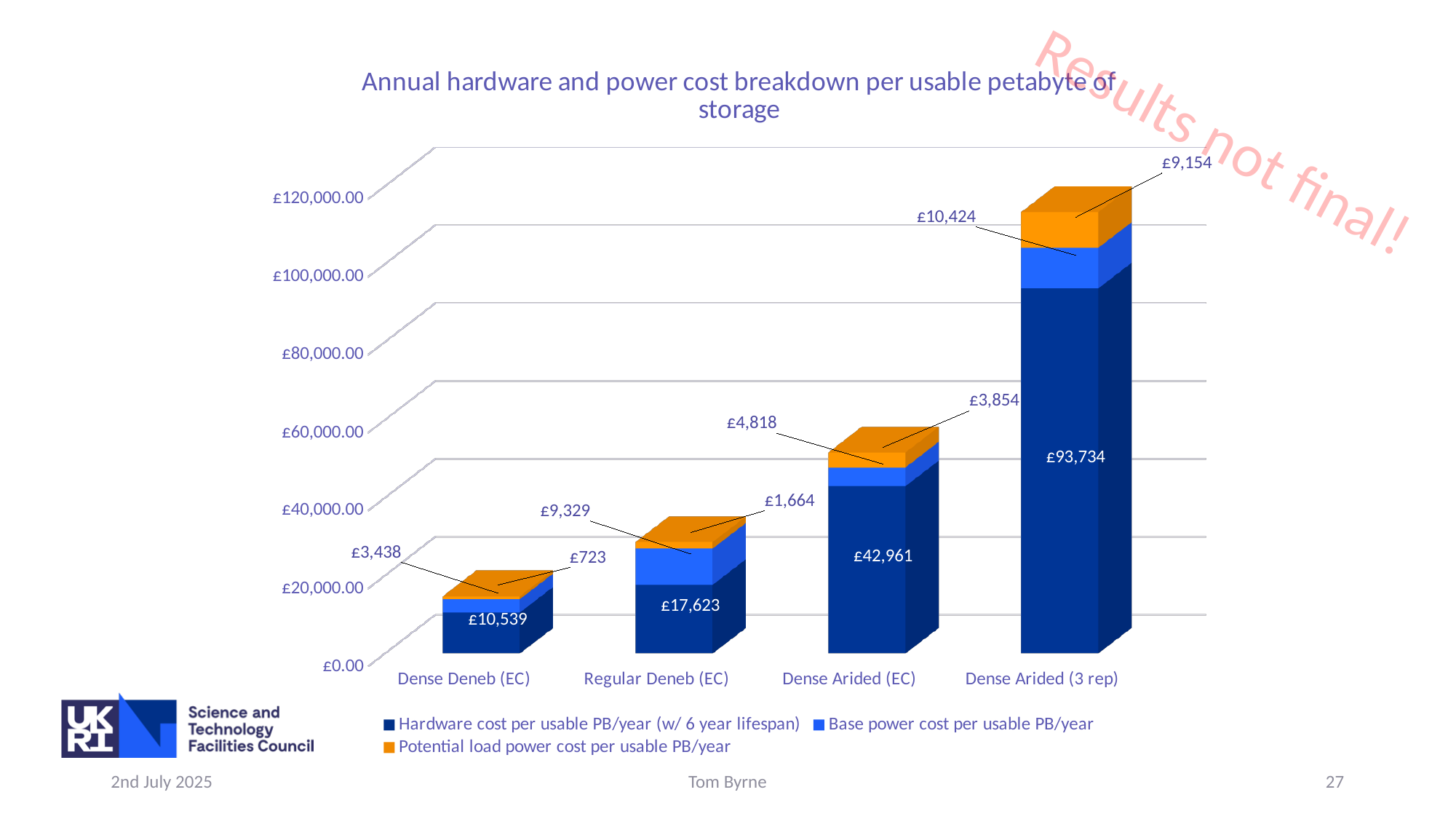
Which configuration has the highest hardware cost per usable PB/year? Dense Arided (3 rep) Which configuration has the lowest hardware cost per usable PB/year? Dense Deneb (EC) What is the hardware cost per usable PB/year for Dense Arided (3 rep)? £93,734 What kind of chart is shown on the slide? bar chart What is the difference in hardware cost per usable PB/year between Dense Arided (EC) and Regular Deneb (EC)? £25,338 How many series does the legend list? 3 What is the total annual cost per usable PB for Dense Deneb (EC), summing all three segments? £14,700 How many storage configurations are shown on the x axis? 4 Which has the larger base power cost per usable PB/year, Regular Deneb (EC) or Dense Arided (EC)? Regular Deneb (EC) Is the total height of the Dense Arided (3 rep) bar greater or less than £100,000.00? greater What is the hardware cost per usable PB/year for Regular Deneb (EC)? £17,623 What is the potential load power cost per usable PB/year for Dense Arided (3 rep)? £9,154